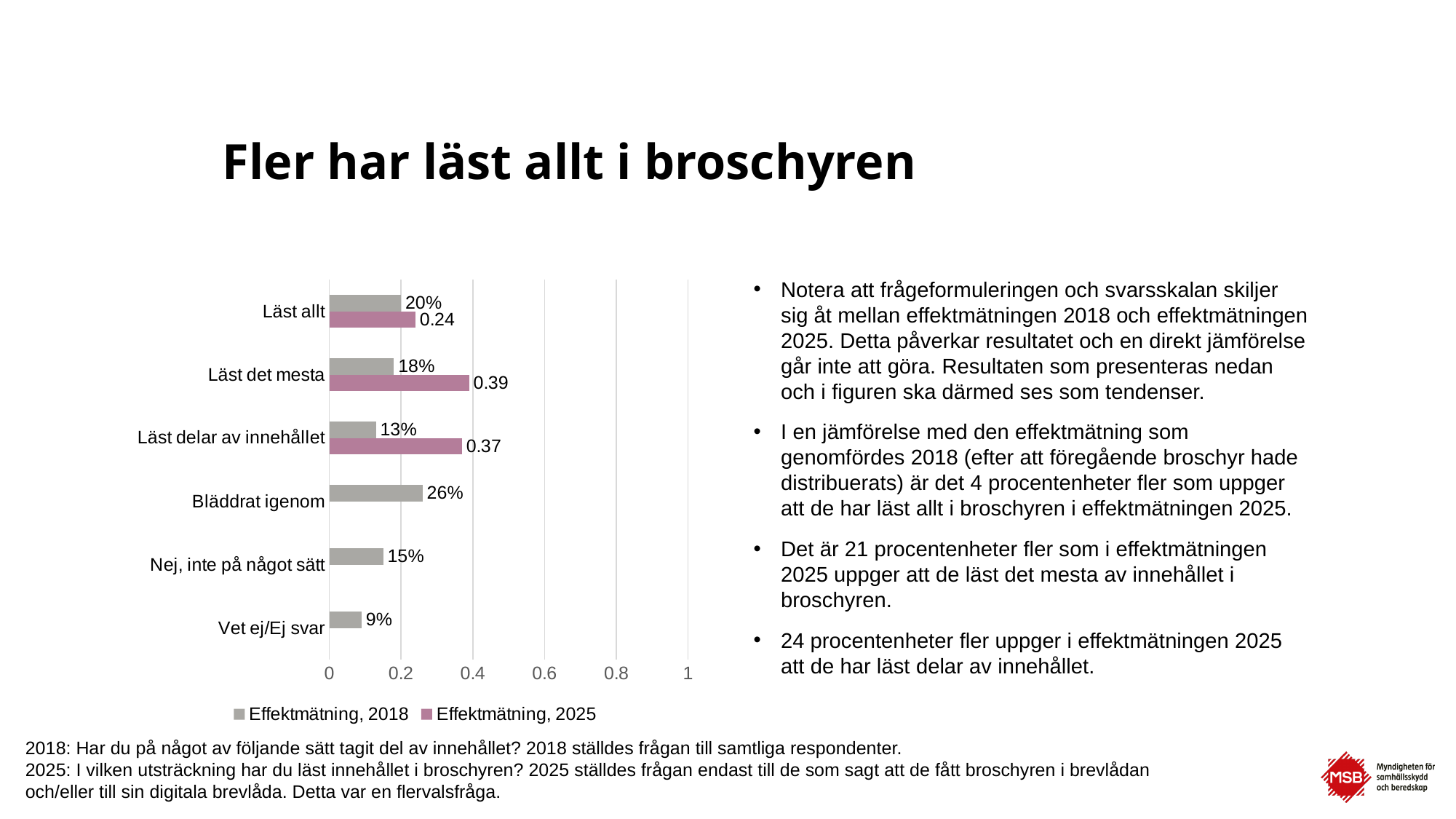
How many categories are shown on the y axis of the chart? 6 What is the Effektmätning, 2025 value for "Läst allt"? 0.24 Which category has the highest Effektmätning, 2025 value? Läst det mesta Which category has the lowest Effektmätning, 2018 value? Vet ej/Ej svar Which is larger: the Effektmätning, 2018 value for "Läst allt" or for "Läst delar av innehållet"? Läst allt What type of chart is shown on the slide? Bar chart What is the difference between the Effektmätning, 2018 values for "Bläddrat igenom" and "Vet ej/Ej svar"? 17 percentage points What is the Effektmätning, 2018 value for "Vet ej/Ej svar"? 9% Which category has the highest Effektmätning, 2018 value? Bläddrat igenom How many series does the chart legend list? 2 What is the Effektmätning, 2018 value for "Bläddrat igenom"? 26% What is the Effektmätning, 2025 value for "Läst det mesta"? 0.39